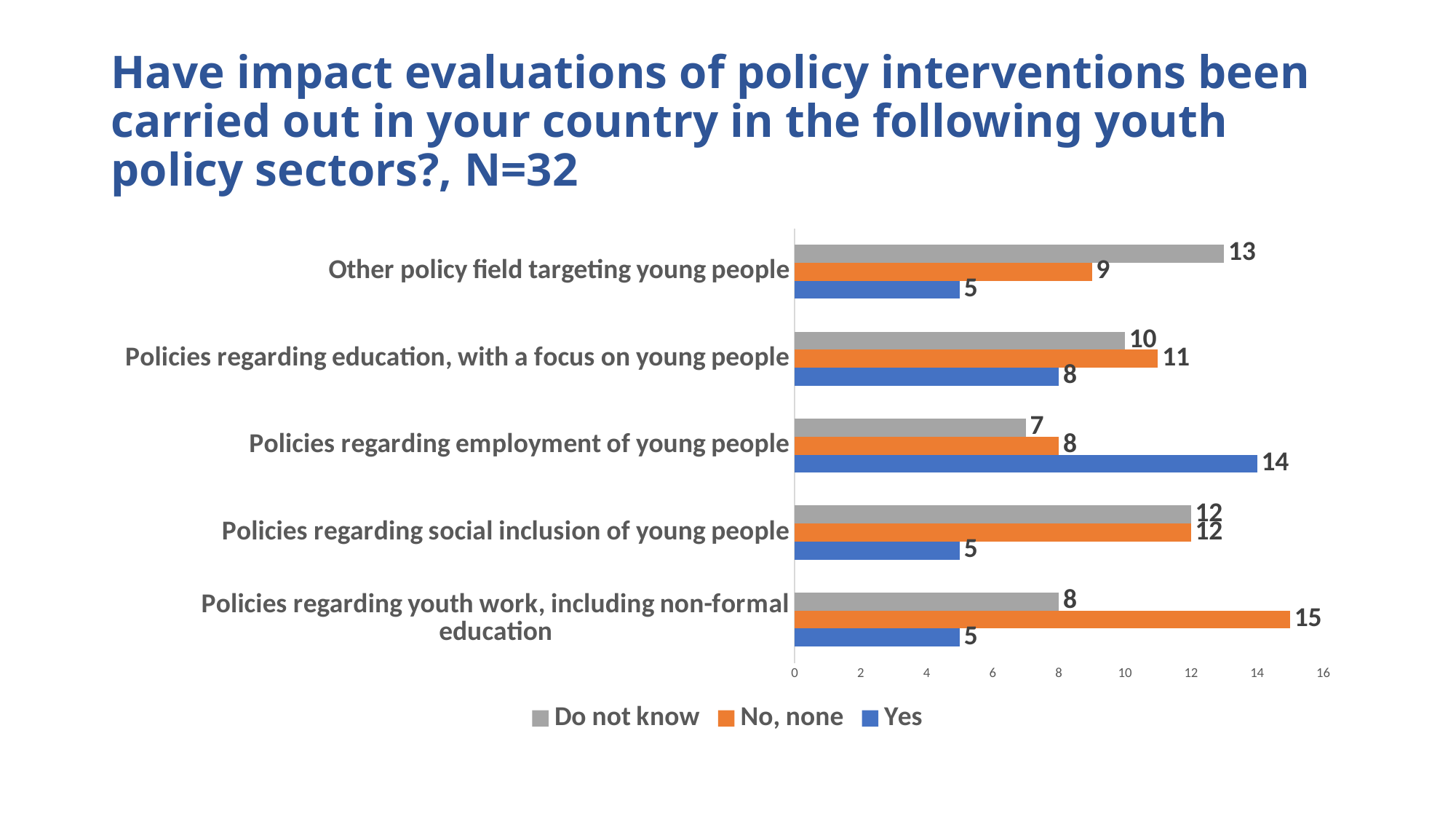
What is the difference between the 'No, none' and 'Yes' values for Policies regarding youth work, including non-formal education? 10 What is the 'Do not know' value for Other policy field targeting young people? 13 How many policy sector categories are shown on the chart? 5 What is the total of the three values for Policies regarding social inclusion of young people? 29 How many series does the legend list? 3 For Policies regarding education, with a focus on young people, which is larger: 'No, none' or 'Do not know'? No, none Which category has the lowest 'Do not know' value? Policies regarding employment of young people What is the 'No, none' value for Policies regarding youth work, including non-formal education? 15 Which category has the highest 'Yes' value? Policies regarding employment of young people What kind of chart is shown on the slide? Bar chart Which colour represents the 'Yes' series in the legend? Blue What is the 'Yes' value for Policies regarding employment of young people? 14